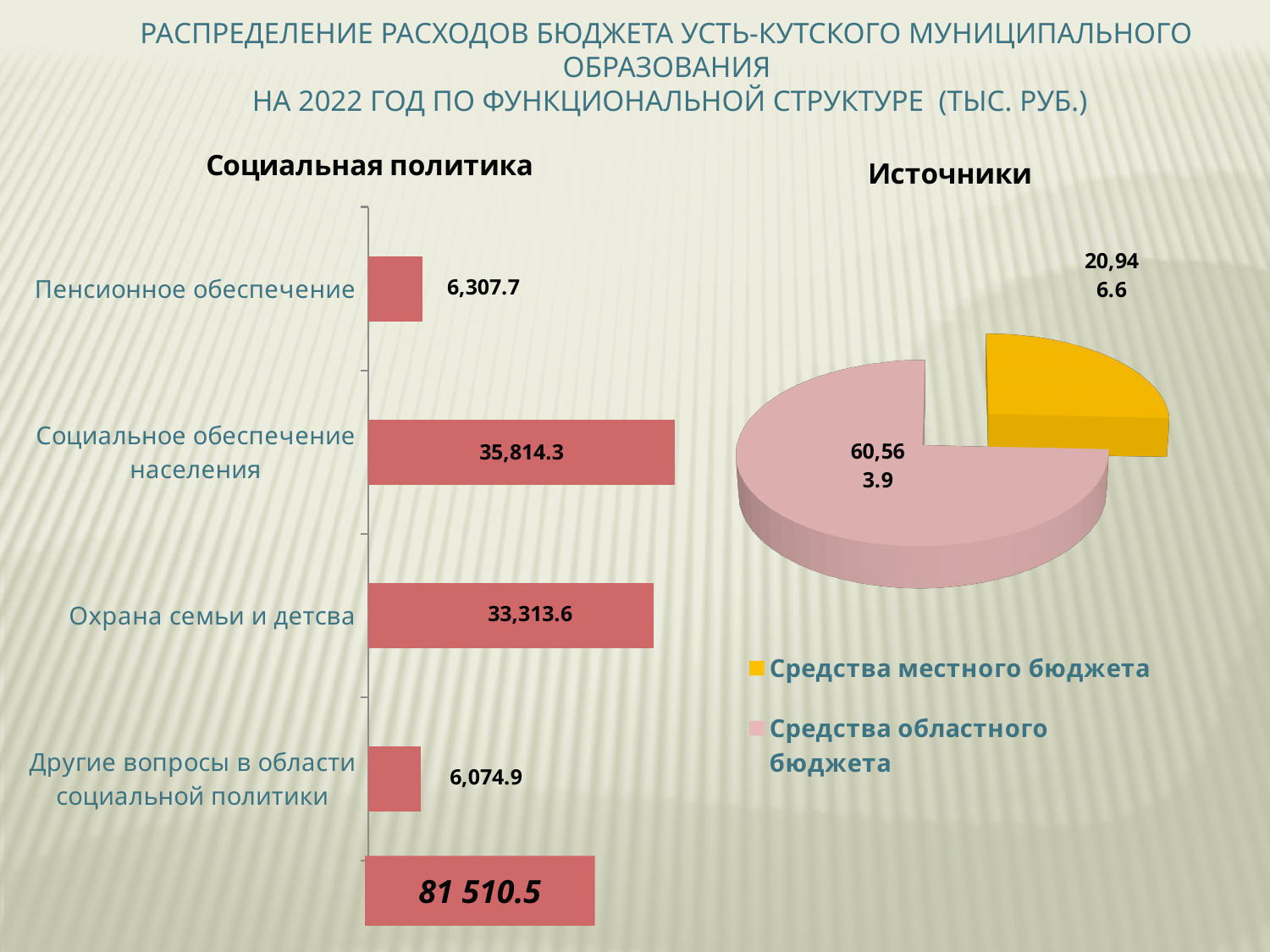
In the 'Социальная политика' chart, which is larger: 'Пенсионное обеспечение' or 'Другие вопросы в области социальной политики'? Пенсионное обеспечение In the 'Социальная политика' chart, what is the value for 'Охрана семьи и детсва'? 33,313.6 In the 'Социальная политика' chart, which category has the lowest value? Другие вопросы в области социальной политики In the 'Социальная политика' chart, what is the value for 'Другие вопросы в области социальной политики'? 6,074.9 How many categories are shown in the 'Социальная политика' bar chart? 4 What type of chart is the 'Социальная политика' chart? bar chart In the 'Источники' pie chart, what is the value for 'Средства областного бюджета'? 60,563.9 In the 'Социальная политика' chart, what is the value for 'Пенсионное обеспечение'? 6,307.7 In the 'Социальная политика' chart, which category has the highest value? Социальное обеспечение населения In the 'Социальная политика' chart, what is the value for 'Социальное обеспечение населения'? 35,814.3 In the 'Социальная политика' chart, what is the difference between 'Социальное обеспечение населения' and 'Охрана семьи и детсва'? 2,500.7 In the 'Источники' pie chart, what is the value for 'Средства местного бюджета'? 20,946.6